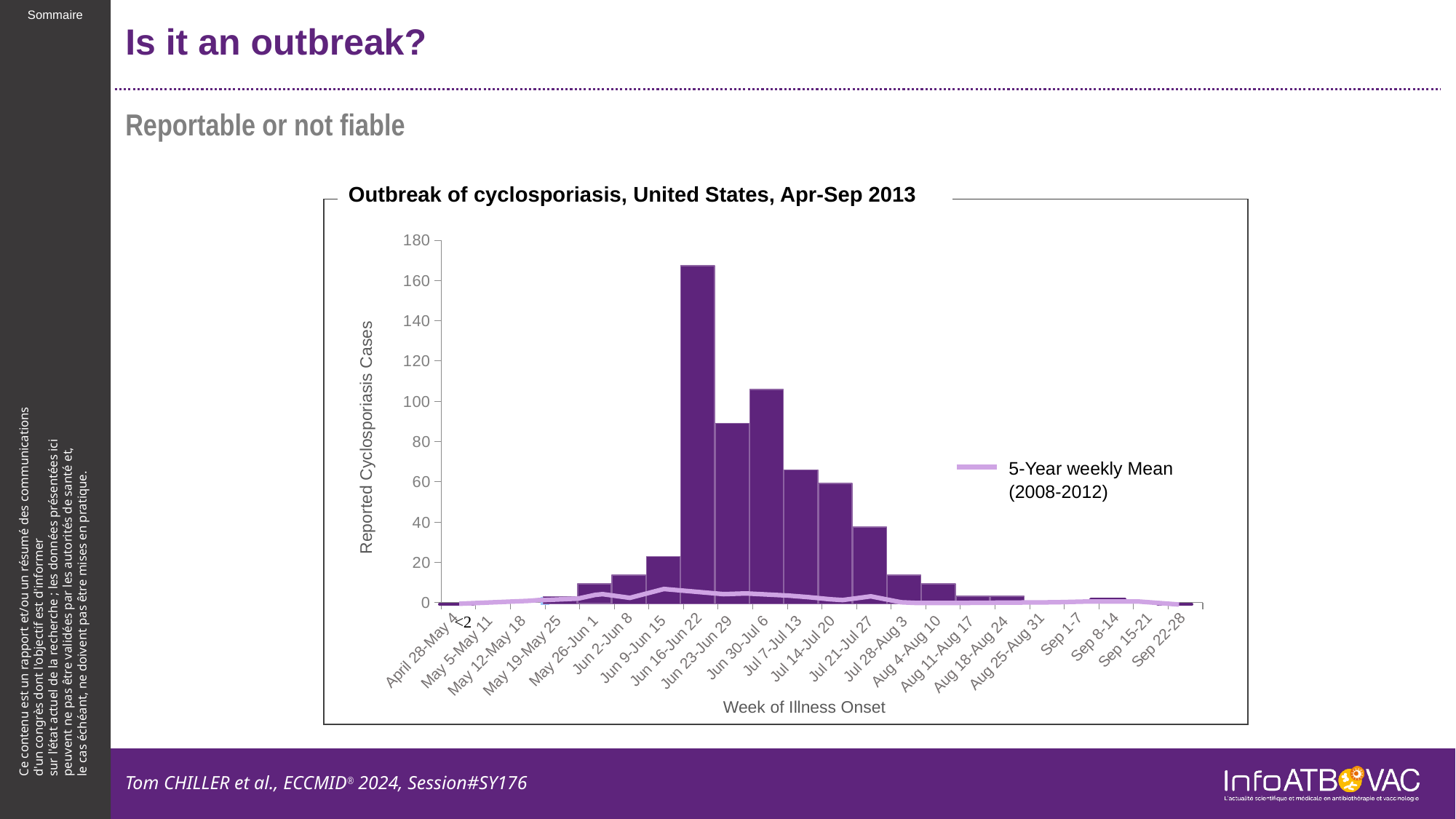
Which week has more reported cases, Jun 23-Jun 29 or Jun 30-Jul 6? Jun 30-Jul 6 Is the value for Jun 16-Jun 22 greater or less than 160? greater What is the title of the chart? Outbreak of cyclosporiasis, United States, Apr-Sep 2013 Is the value for Jun 23-Jun 29 greater or less than 80? greater From Jun 16-Jun 22 to Jul 28-Aug 3, do the reported cases rise or fall? Fall What kind of chart is used to show the reported cyclosporiasis cases? Bar chart Is the value for Jun 9-Jun 15 greater or less than 20? greater How many weeks of illness onset are shown on the x axis? 22 Which week of illness onset has the highest number of reported cyclosporiasis cases? Jun 16-Jun 22 How many series does the legend list? 1